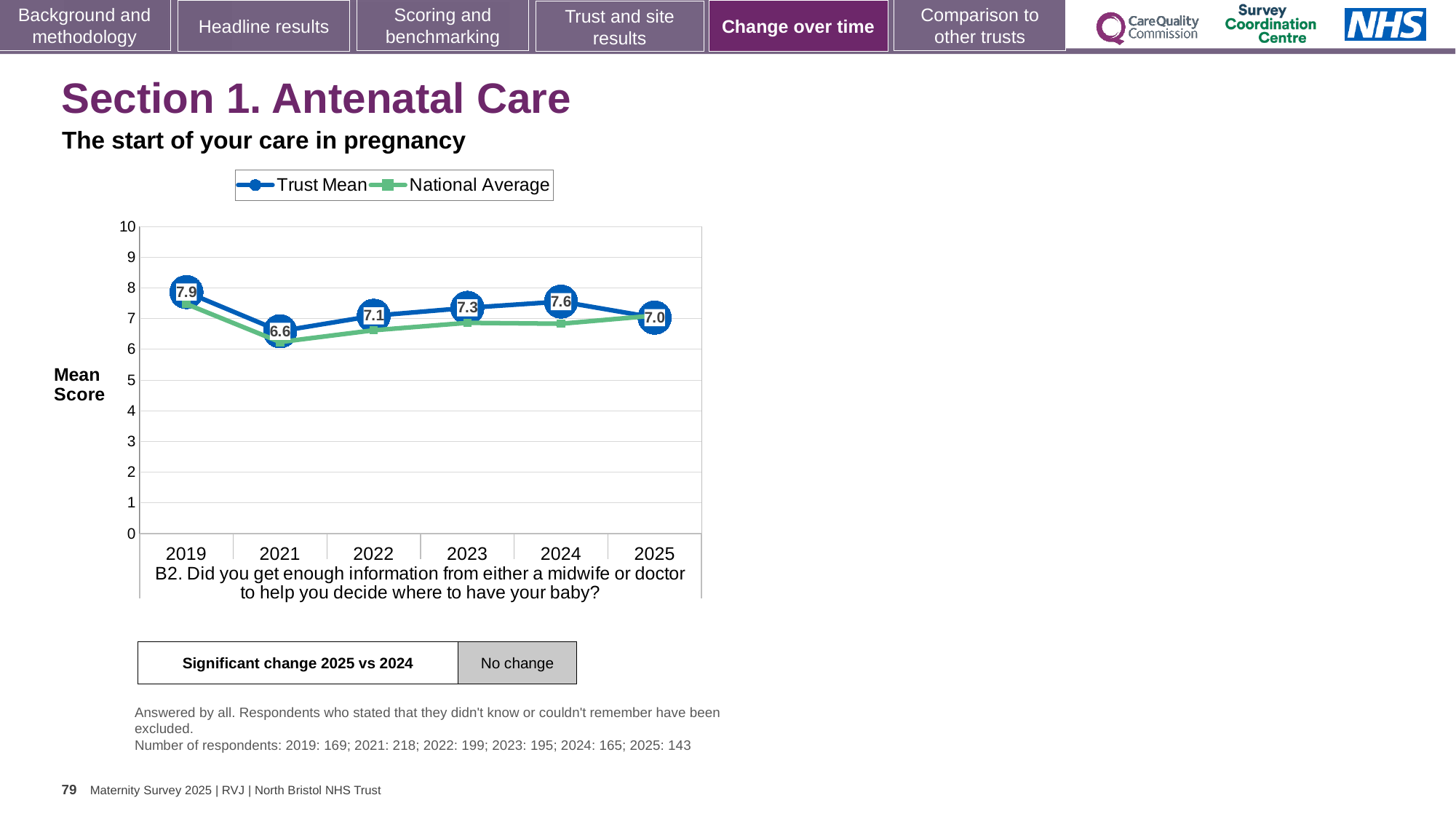
In which year is the Trust Mean lowest? 2021 Does the Trust Mean rise or fall from 2021 to 2024? rise What is the Trust Mean for 2019? 7.9 What is the difference between the Trust Mean in 2019 and in 2021? 1.3 How many years are shown on the x axis? 6 What is the Trust Mean for 2025? 7.0 Is the National Average for 2021 greater or less than 7? less How many series does the legend list? 2 In which year is the Trust Mean highest? 2019 Which is larger, the Trust Mean in 2024 or in 2025? 2024 What kind of chart is shown? line chart What is the Trust Mean for 2021? 6.6